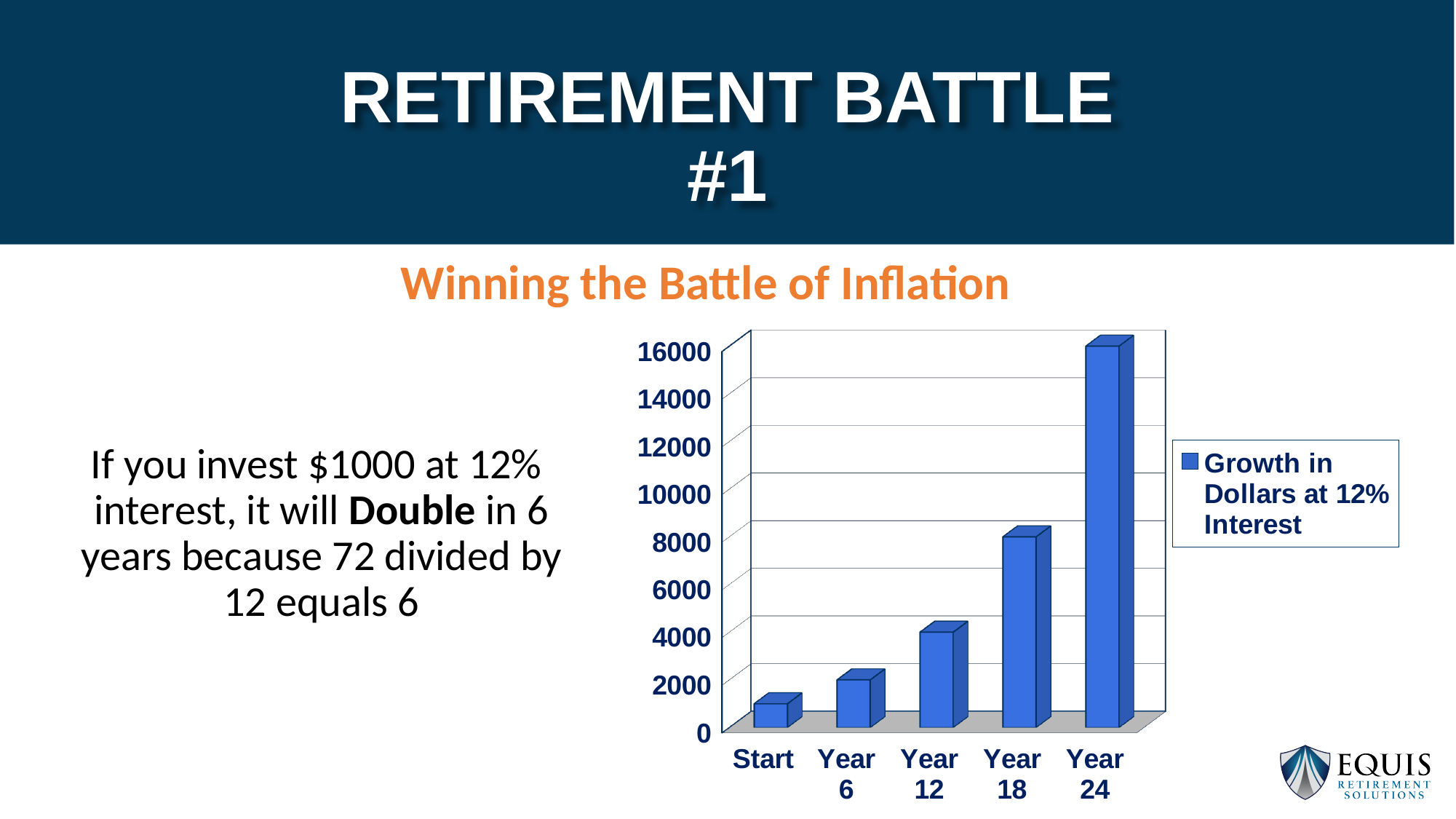
What is the legend entry for the series in the chart? Growth in Dollars at 12% Interest How many series does the chart legend list? 1 What kind of chart is shown on the slide? Bar chart Which category has the highest value in the chart? Year 24 Is the value for Year 18 greater or less than 6000? greater Which category has the lowest value in the chart? Start Is the value for Start greater or less than 2000? less Which is larger, the value for Year 12 or the value for Year 18? Year 18 Do the values rise or fall from Start to Year 24? Rise Is the value for Year 24 greater or less than 14000? greater What is the highest value shown on the vertical axis of the chart? 16000 How many categories are shown on the x axis of the chart? 5